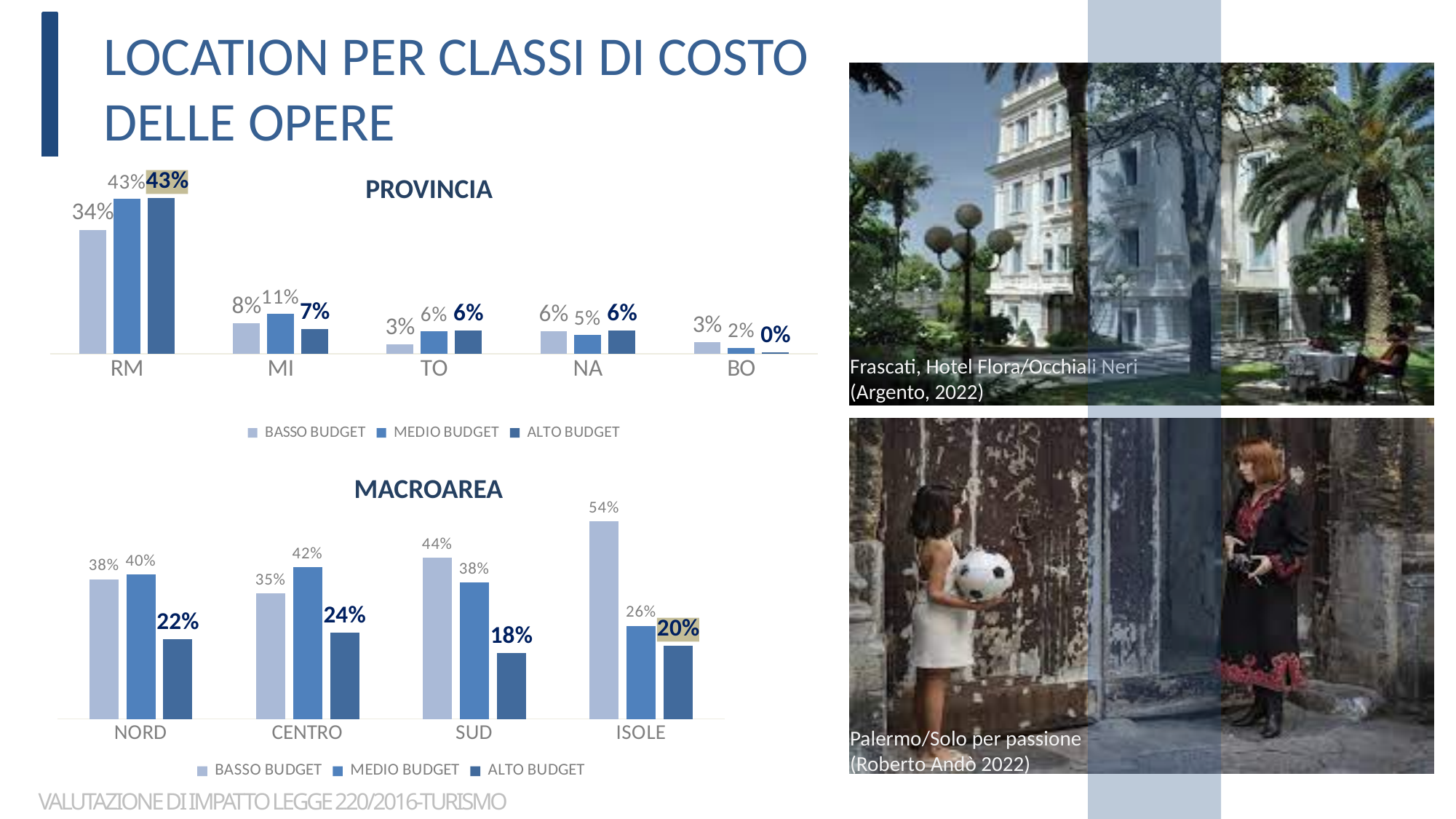
In the PROVINCIA chart, which province has the lowest ALTO BUDGET value? BO In the PROVINCIA chart, what is the BASSO BUDGET value for RM? 34% In the MACROAREA chart, what is the ALTO BUDGET value for SUD? 18% In the MACROAREA chart, what is the BASSO BUDGET value for ISOLE? 54% In the MACROAREA chart, what is the difference between the BASSO BUDGET and ALTO BUDGET values for ISOLE? 34% How many series does the legend of the MACROAREA chart list? 3 In the PROVINCIA chart, what is the difference between the MEDIO BUDGET and BASSO BUDGET values for RM? 9% In the PROVINCIA chart, which province has the highest MEDIO BUDGET value? RM In the MACROAREA chart, which macroarea has the highest ALTO BUDGET value? CENTRO In the PROVINCIA chart, what is the ALTO BUDGET value for MI? 7% In the MACROAREA chart, is the MEDIO BUDGET value for NORD larger or smaller than the MEDIO BUDGET value for CENTRO? smaller In the PROVINCIA chart, how many provinces are shown on the x axis? 5